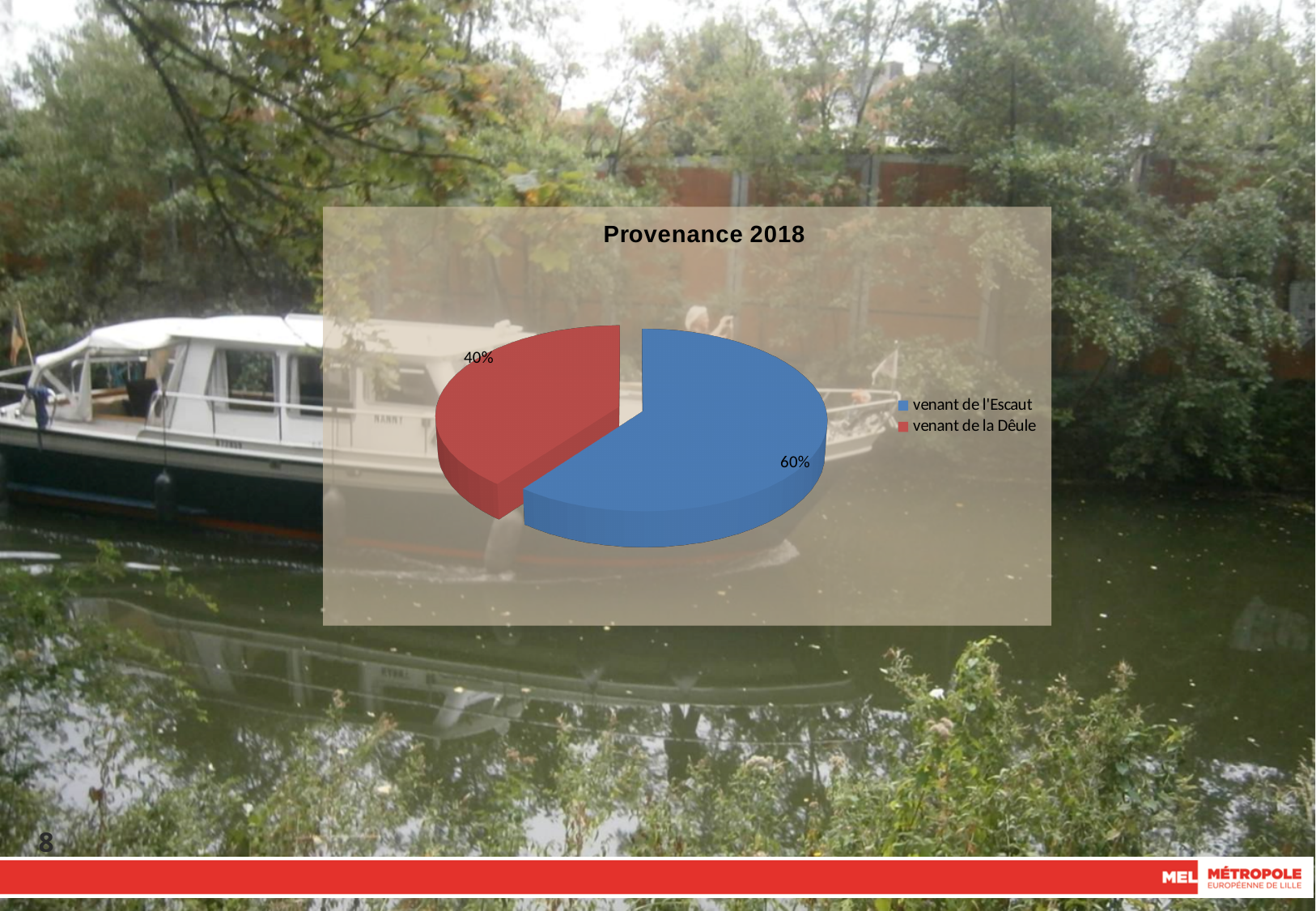
Which category has the largest share of the pie? venant de l'Escaut Which is larger: the share for 'venant de l'Escaut' or 'venant de la Dêule'? venant de l'Escaut What share of the pie is 'venant de la Dêule'? 40% What is the title of the chart? Provenance 2018 What kind of chart is shown on the slide? pie chart What colour is the slice for 'venant de la Dêule'? red How many entries does the legend list? 2 How many slices does the pie chart have? 2 What share of the pie is 'venant de l'Escaut'? 60% What is the difference in percentage points between the 'venant de l'Escaut' and 'venant de la Dêule' shares? 20% Which category has the smallest share of the pie? venant de la Dêule